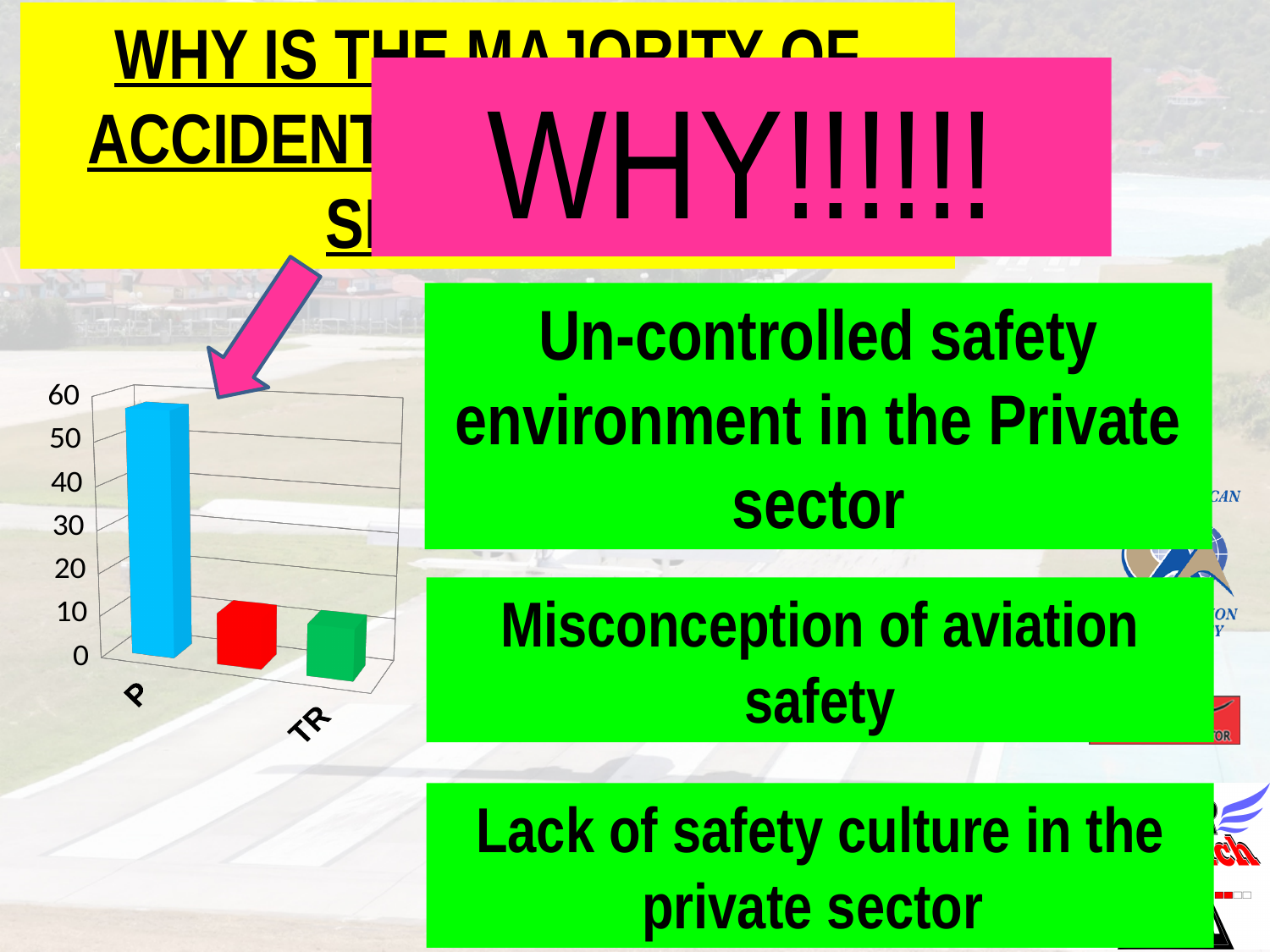
What colour is the tallest bar in the chart? blue Is the value for P greater or less than 50? greater How many bars are plotted in the chart? 3 Which is larger, the value for P or the value for TR? P Which category has the highest value in the chart? P What is the highest value shown on the vertical axis of the chart? 60 Is the value for TR greater or less than 20? less What kind of chart is shown on the left of the slide? bar chart